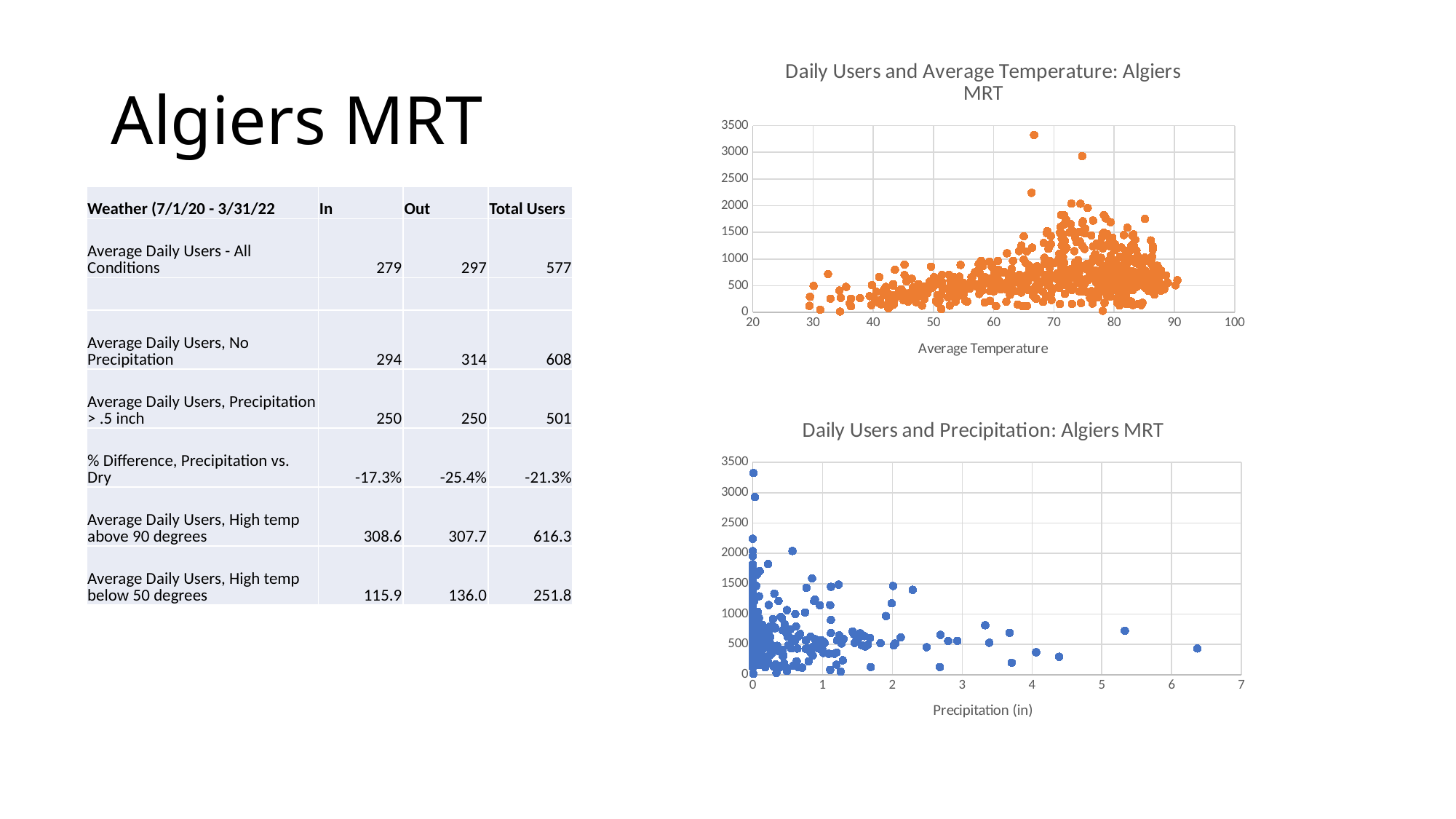
In the "Daily Users and Precipitation: Algiers MRT" chart, do the daily user values generally rise or fall as precipitation increases? fall What kind of chart is "Daily Users and Precipitation: Algiers MRT"? Scatter chart What is the x-axis title of the top chart on the right? Average Temperature In the "Daily Users and Precipitation: Algiers MRT" chart, is the highest plotted value greater or less than 3000? greater What kind of chart is "Daily Users and Average Temperature: Algiers MRT"? Scatter chart What is the x-axis title of the bottom chart on the right? Precipitation (in) In the "Daily Users and Precipitation: Algiers MRT" chart, is the value of the point plotted at about 6.4 inches of precipitation greater or less than 1000? less In the "Daily Users and Average Temperature: Algiers MRT" chart, is the highest plotted value greater or less than 3000? greater In the "Daily Users and Average Temperature: Algiers MRT" chart, what is the maximum value shown on the y axis? 3500 In the "Daily Users and Average Temperature: Algiers MRT" chart, do daily user values generally rise or fall as average temperature increases from 30 to 80? rise